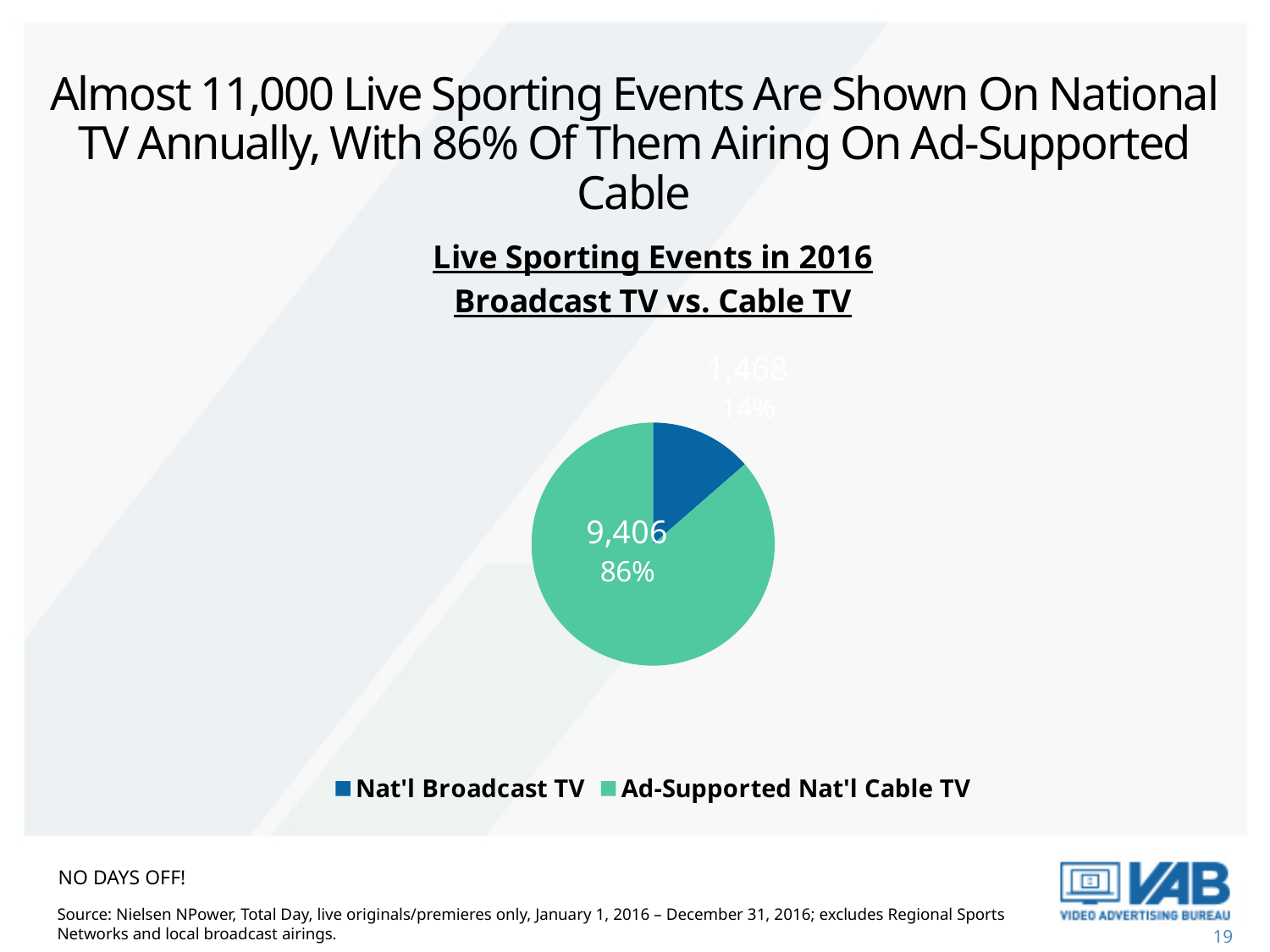
What share of live sporting events in 2016 aired on Nat'l Broadcast TV? 14% Which category has the smallest slice of the pie? Nat'l Broadcast TV How many live sporting events aired on Ad-Supported Nat'l Cable TV in 2016? 9,406 Which had more live sporting events in 2016, Nat'l Broadcast TV or Ad-Supported Nat'l Cable TV? Ad-Supported Nat'l Cable TV How many categories does the pie chart show? 2 What is the total number of live sporting events shown across both slices of the pie? 10,874 Which category has the largest slice of the pie? Ad-Supported Nat'l Cable TV What share of live sporting events in 2016 aired on Ad-Supported Nat'l Cable TV? 86% What type of chart is shown on the slide? Pie chart How many more live sporting events aired on Ad-Supported Nat'l Cable TV than on Nat'l Broadcast TV? 7,938 How many live sporting events aired on Nat'l Broadcast TV in 2016? 1,468 What is the title of the chart? Live Sporting Events in 2016 Broadcast TV vs. Cable TV